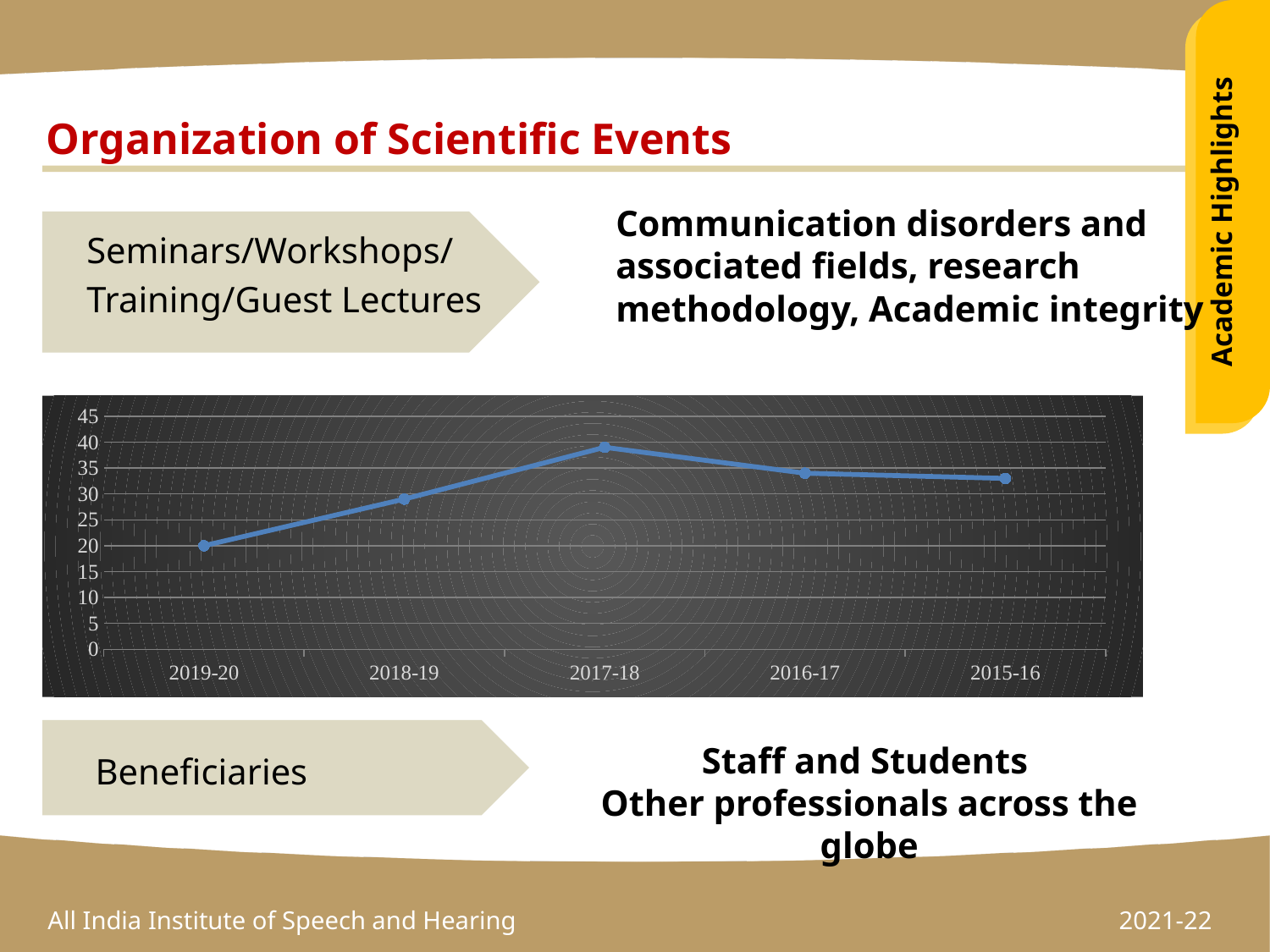
Moving from 2019-20 to 2017-18 along the x axis, do the values rise or fall? rise Which is larger, the value for 2018-19 or the value for 2019-20? 2018-19 Which academic year has the lowest value on the chart? 2019-20 Which academic year has the highest value on the chart? 2017-18 How many academic years are plotted on the x axis of the chart? 5 What kind of chart is shown on the slide? line chart Is the value for 2015-16 greater or less than 35? less Is the value for 2017-18 greater or less than 35? greater Is the value for 2018-19 greater or less than 25? greater Which is larger, the value for 2017-18 or the value for 2015-16? 2017-18 What is the value plotted for 2019-20? 20